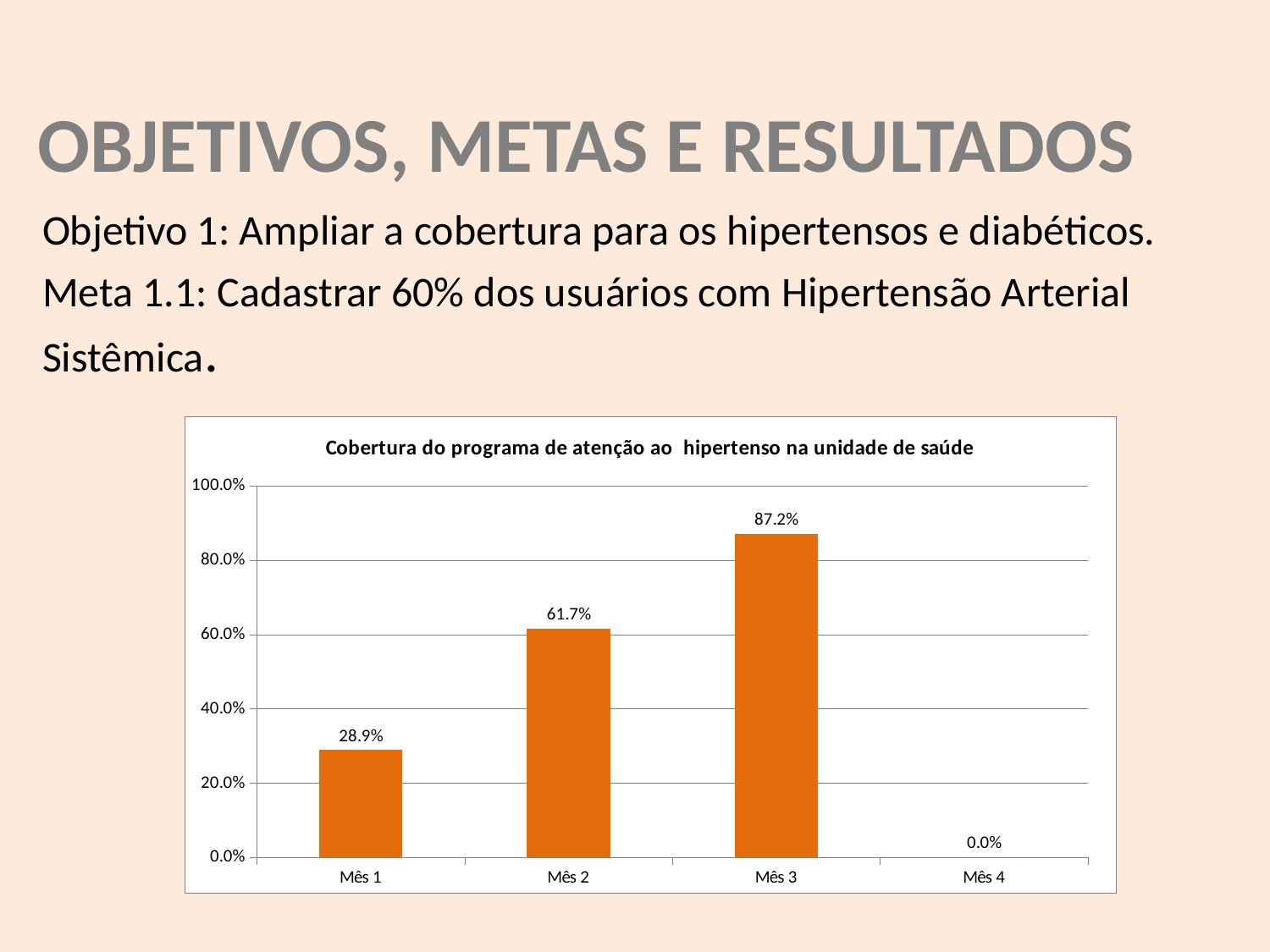
How many months are shown on the x axis? 4 What is the value for Mês 3? 87.2% Which is larger, the value for Mês 1 or the value for Mês 2? Mês 2 What is the difference between the values for Mês 2 and Mês 1? 32.8% What kind of chart is shown? bar chart What is the value for Mês 1? 28.9% Which month has the lowest value? Mês 4 Is the value for Mês 3 greater or less than 80.0%? greater What is the difference between the values for Mês 3 and Mês 2? 25.5% Which month has the highest value? Mês 3 What is the value for Mês 4? 0.0% What is the value for Mês 2? 61.7%